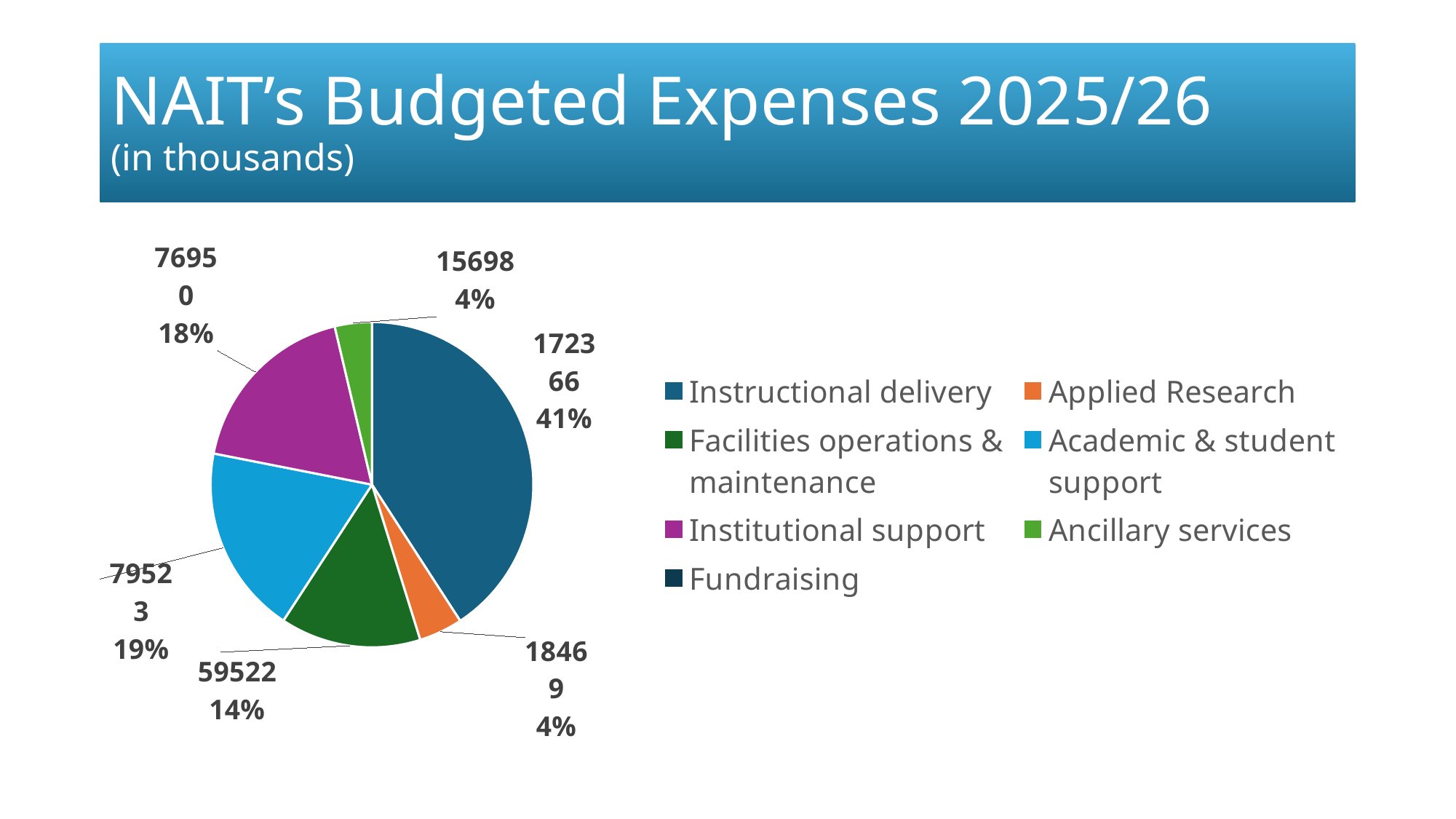
What share of the pie does Academic & student support represent? 19% What share of the pie does Applied Research represent? 4% Which category has the largest share of the pie? Instructional delivery What is the value shown for Facilities operations & maintenance? 59522 Which has the larger share: Academic & student support or Institutional support? Academic & student support What is the title of the chart on the slide? NAIT's Budgeted Expenses 2025/26 What share of the pie does Instructional delivery represent? 41% What is the value shown for Ancillary services? 15698 What kind of chart is shown on the slide? Pie chart How many categories does the legend list? 7